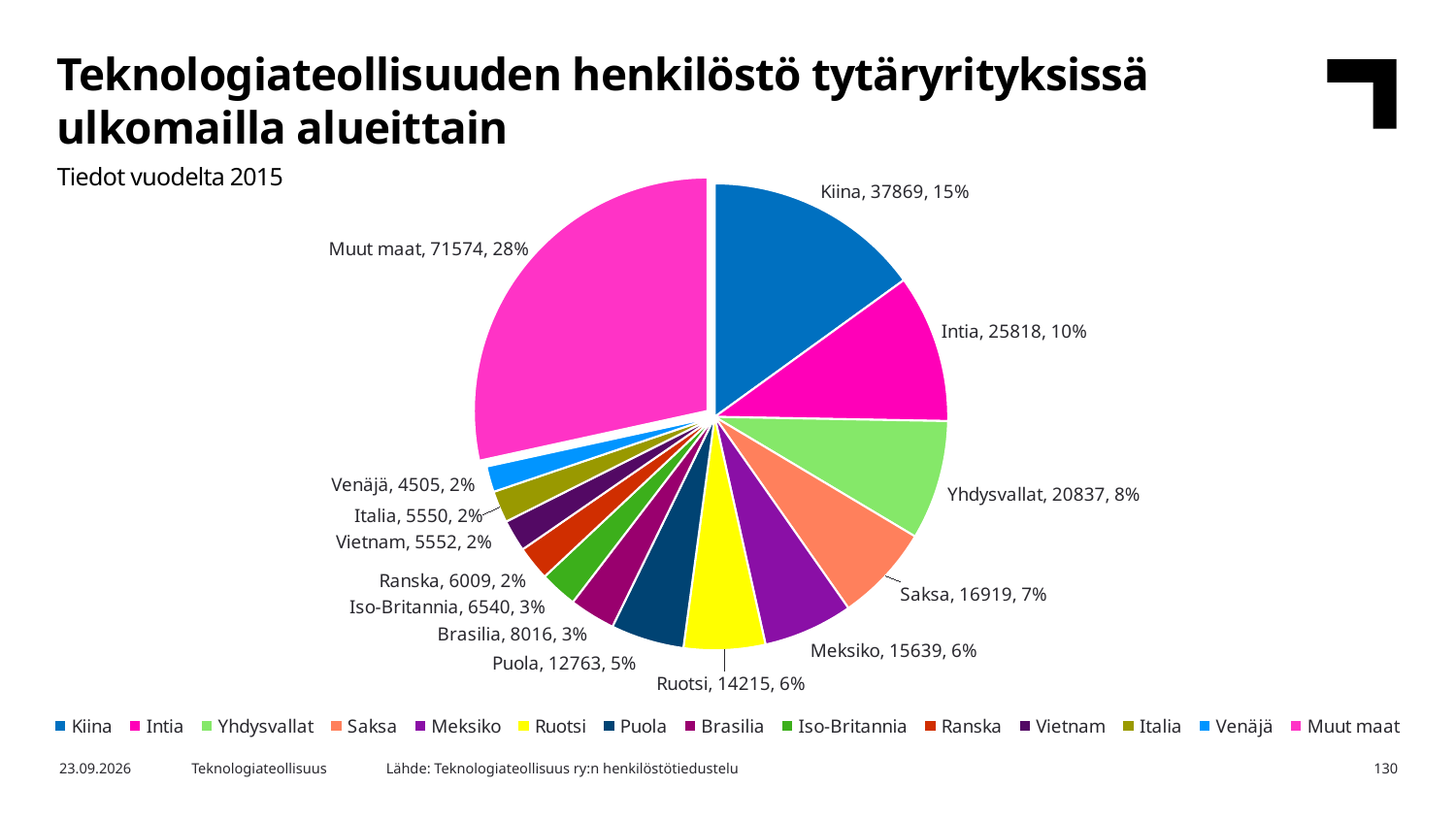
What is the value for Puola? 12763 Which category has the smallest slice? Venäjä Which is larger, the value for Meksiko or the value for Ruotsi? Meksiko What share of the pie does Intia represent? 10% What type of chart is shown on the slide? pie chart What is the title of the chart? Teknologiateollisuuden henkilöstö tytäryrityksissä ulkomailla alueittain What is the value for Kiina? 37869 Which category has the largest slice? Muut maat How many slices does the pie chart have? 14 What is the value for Saksa? 16919 What share of the pie does Muut maat represent? 28% What is the difference between the values for Kiina and Intia? 12051